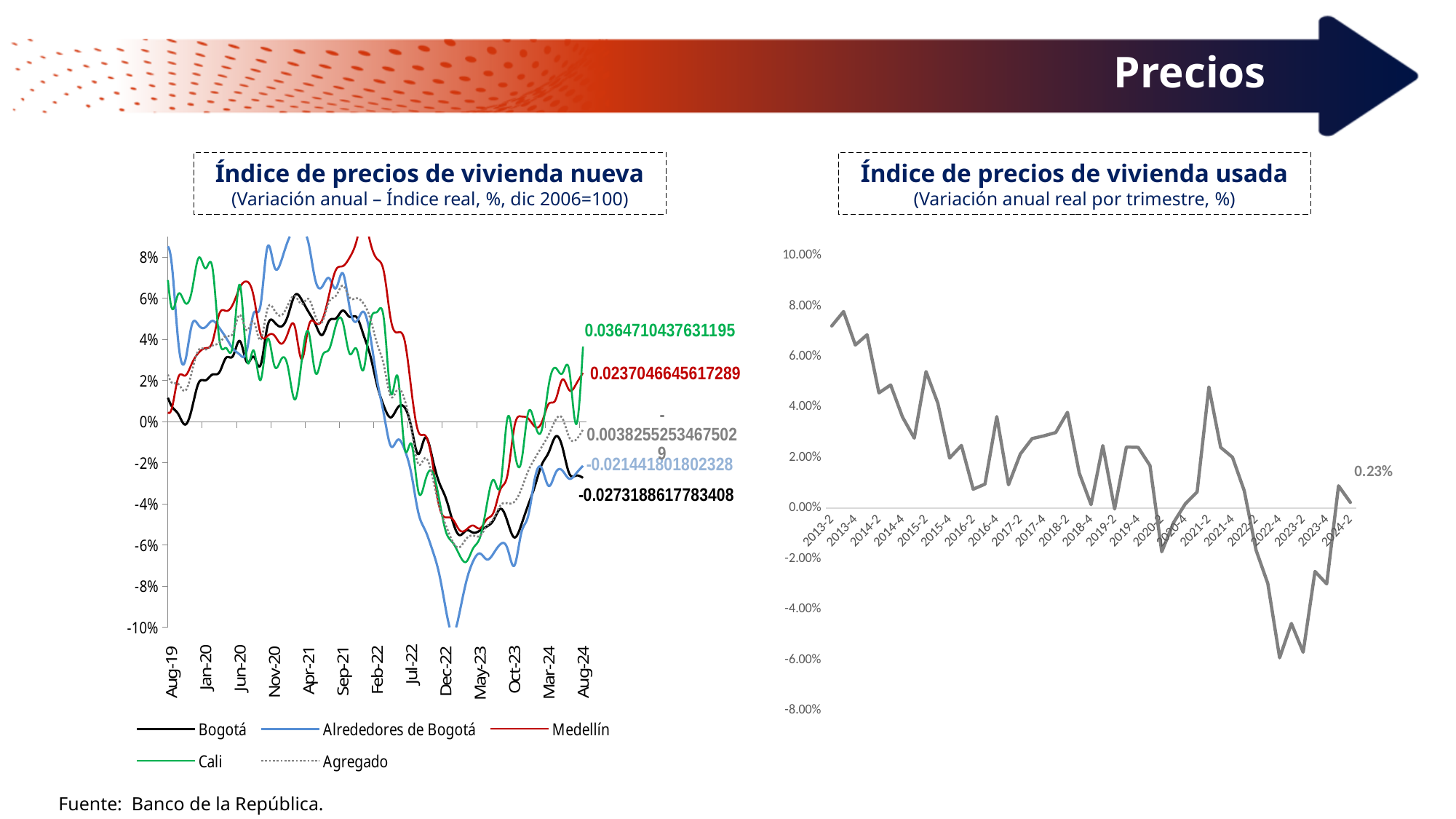
In the 'Índice de precios de vivienda nueva' chart, is the value for Alrededores de Bogotá around Dec-22 greater or less than -8%? less In the 'Índice de precios de vivienda nueva' chart, what is the final labelled value for Bogotá? -0.0273188617783408 In the 'Índice de precios de vivienda usada' chart, what is the labelled value at the last point (2024-2)? 0.23% In the 'Índice de precios de vivienda nueva' chart, which series has the lowest final labelled value? Bogotá In the 'Índice de precios de vivienda usada' chart, is the value at 2013-2 greater or less than 6.00%? greater What kind of chart is the 'Índice de precios de vivienda nueva' chart? line chart In the 'Índice de precios de vivienda nueva' chart, which series has the highest final labelled value? Cali In the 'Índice de precios de vivienda nueva' chart, what is the final labelled value for Medellín? 0.0237046645617289 In the 'Índice de precios de vivienda nueva' chart, what is the final labelled value for Cali? 0.0364710437631195 How many series does the legend of the 'Índice de precios de vivienda nueva' chart list? 5 In the 'Índice de precios de vivienda nueva' chart, what is the difference between the final labelled values of Cali and Medellín? 0.0127663792013906 In the 'Índice de precios de vivienda usada' chart, do values overall rise or fall from 2013-2 to 2024-2? fall